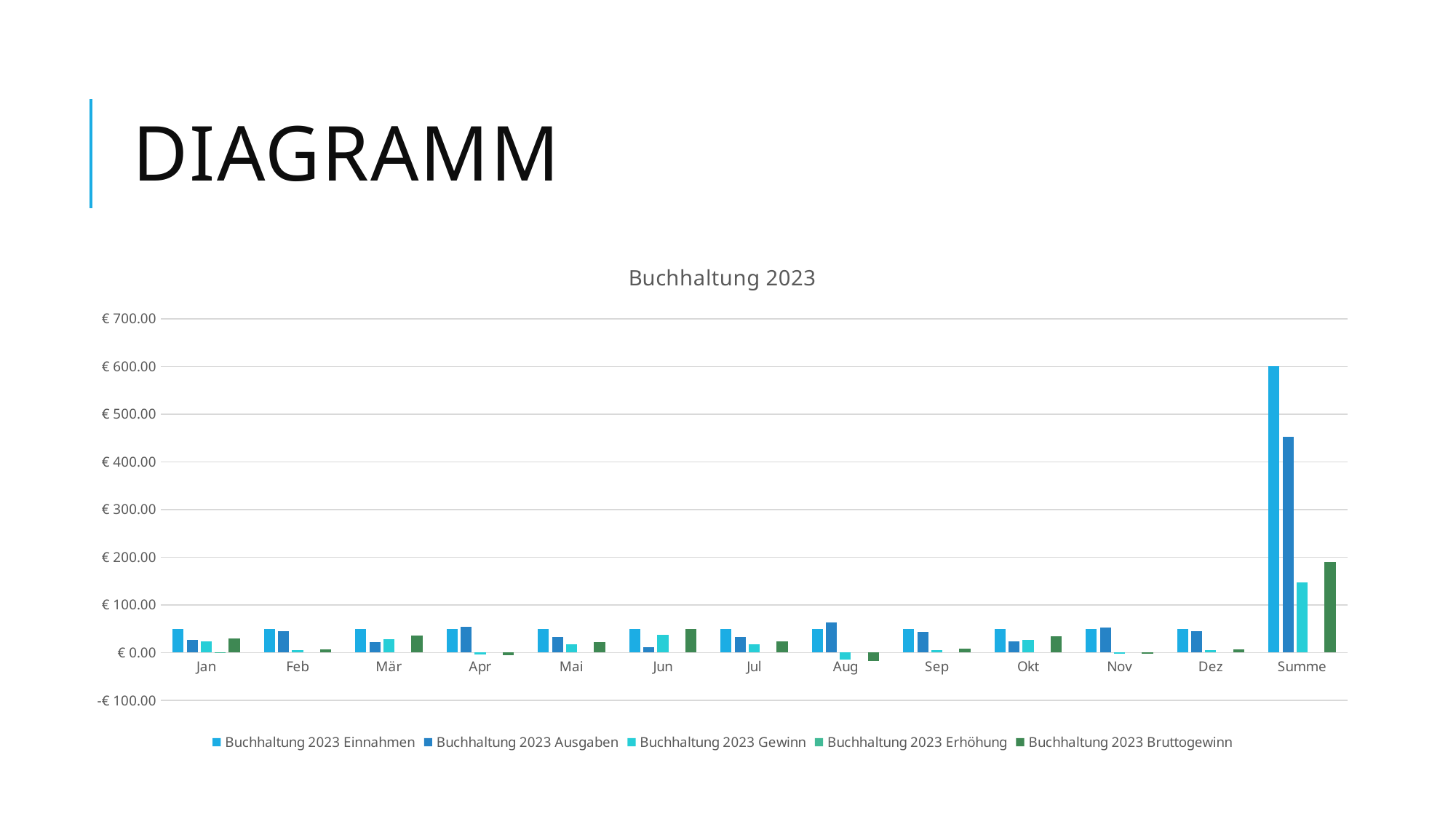
Which category has the highest value for Buchhaltung 2023 Einnahmen? Summe How many series does the legend list? 5 In Aug, which is larger: Buchhaltung 2023 Einnahmen or Buchhaltung 2023 Ausgaben? Buchhaltung 2023 Ausgaben In Summe, which is larger: Buchhaltung 2023 Einnahmen or Buchhaltung 2023 Ausgaben? Buchhaltung 2023 Einnahmen What is the title of the chart? Buchhaltung 2023 Is the value for Buchhaltung 2023 Ausgaben in Summe greater or less than € 400.00? greater Is the value for Buchhaltung 2023 Bruttogewinn in Summe greater or less than € 200.00? less What kind of chart is shown on the slide? bar chart Is the value for Buchhaltung 2023 Bruttogewinn in Aug greater or less than € 0.00? less How many categories are shown on the x axis? 13